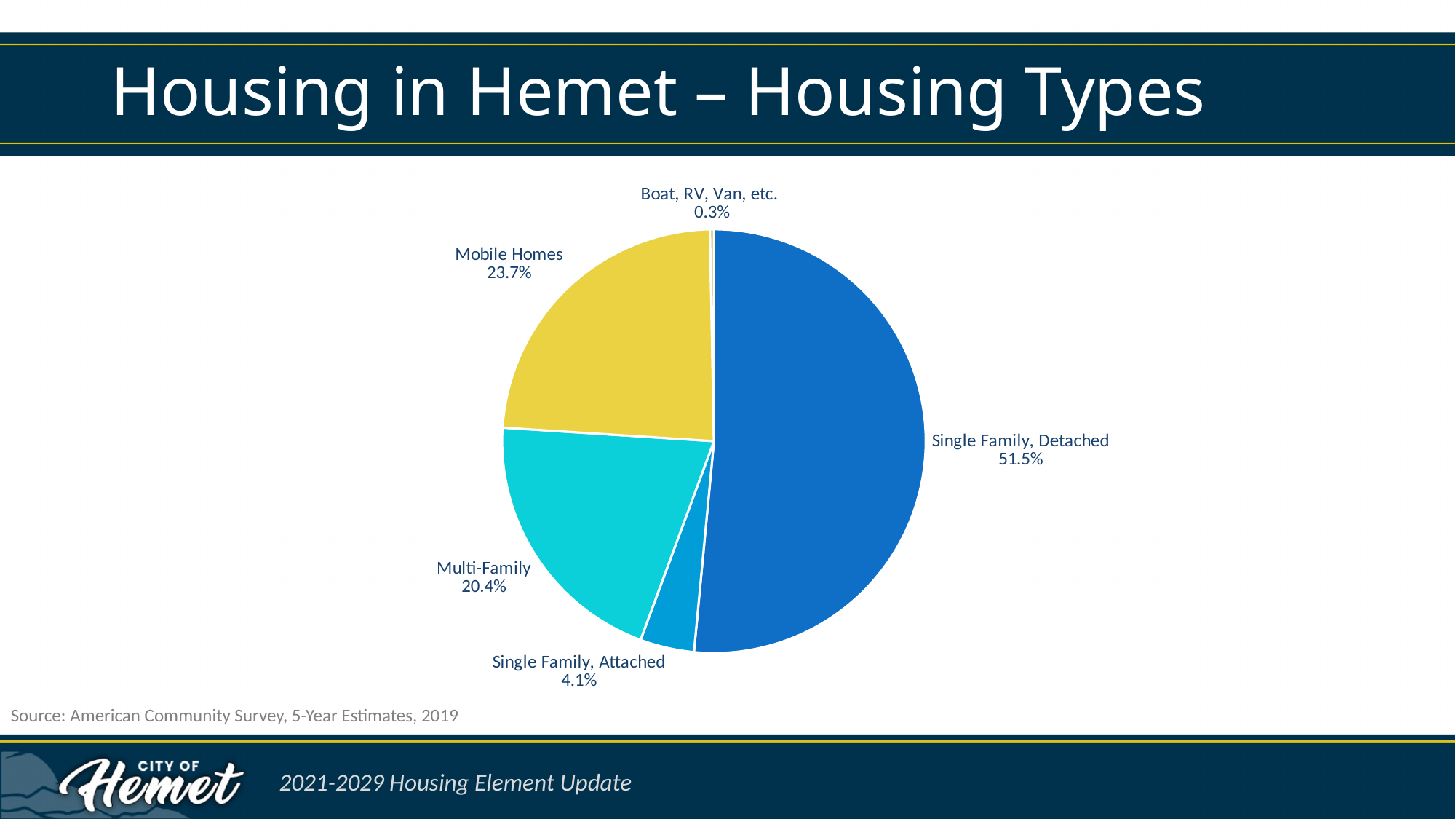
Which is larger, the share for Mobile Homes or the share for Multi-Family? Mobile Homes What share of housing is Multi-Family? 20.4% What kind of chart is shown on the slide? pie chart What share of housing is Single Family, Attached? 4.1% What share of housing is Single Family, Detached? 51.5% Which housing type has the smallest share of the pie? Boat, RV, Van, etc. Which housing type has the largest share of the pie? Single Family, Detached What is the difference in percentage points between Mobile Homes and Multi-Family? 3.3 What share of housing is Mobile Homes? 23.7% How many housing types are shown in the pie chart? 5 What is the source cited for the chart data? American Community Survey, 5-Year Estimates, 2019 What share of housing is Boat, RV, Van, etc.? 0.3%